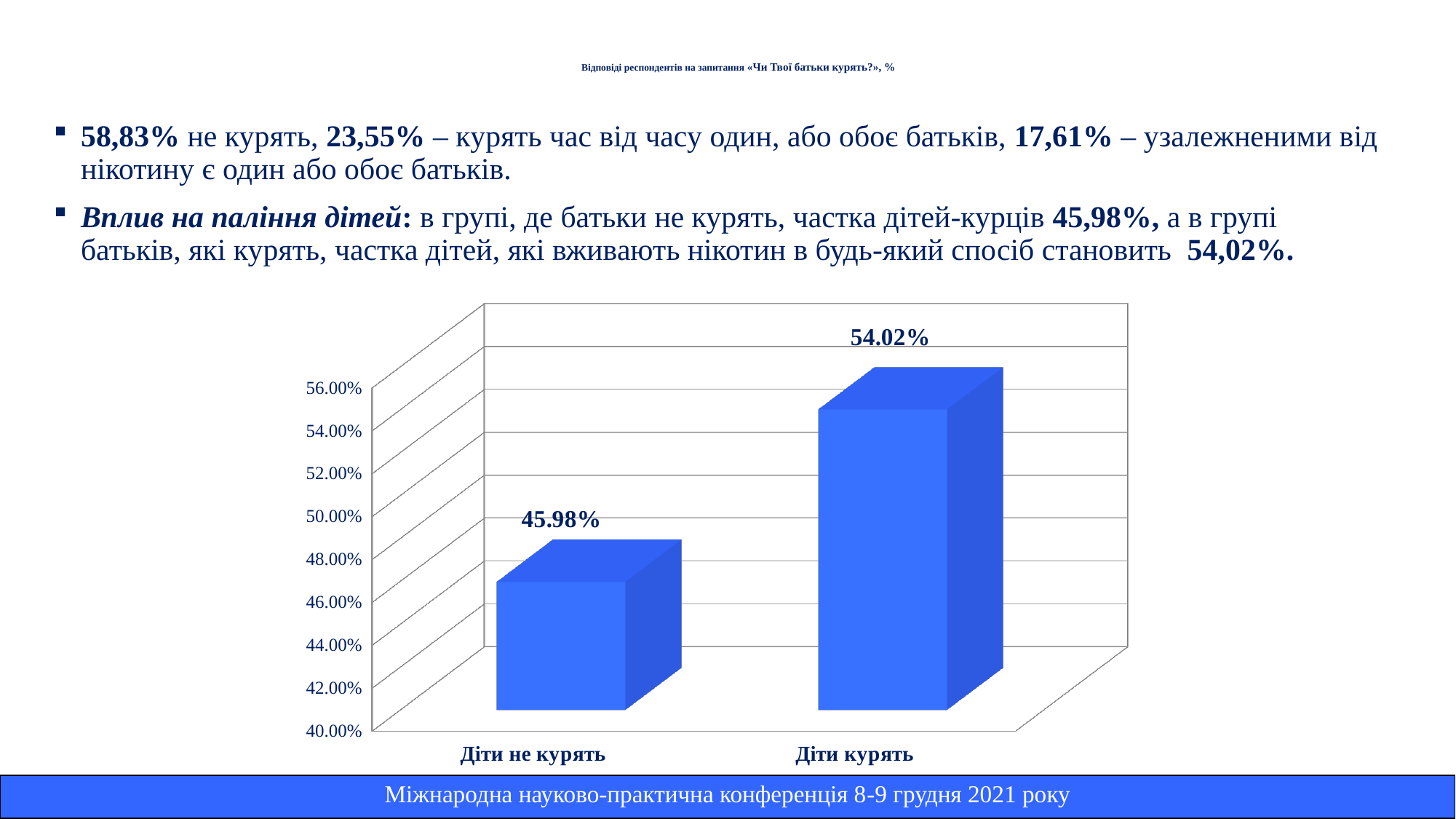
Which is larger: the value for "Діти курять" or the value for "Діти не курять"? Діти курять How many categories are shown on the chart? 2 What kind of chart is shown on the slide? bar chart Which category has the lowest value? Діти не курять What is the difference between the values for "Діти курять" and "Діти не курять"? 8.04% Which category has the highest value? Діти курять What is the lowest value labelled on the vertical axis of the chart? 40.00% Is the value for "Діти курять" greater or less than 52.00%? greater What is the value shown for "Діти курять"? 54.02% What is the value shown for "Діти не курять"? 45.98% What is the highest value labelled on the vertical axis of the chart? 56.00% Is the value for "Діти не курять" greater or less than 50.00%? less